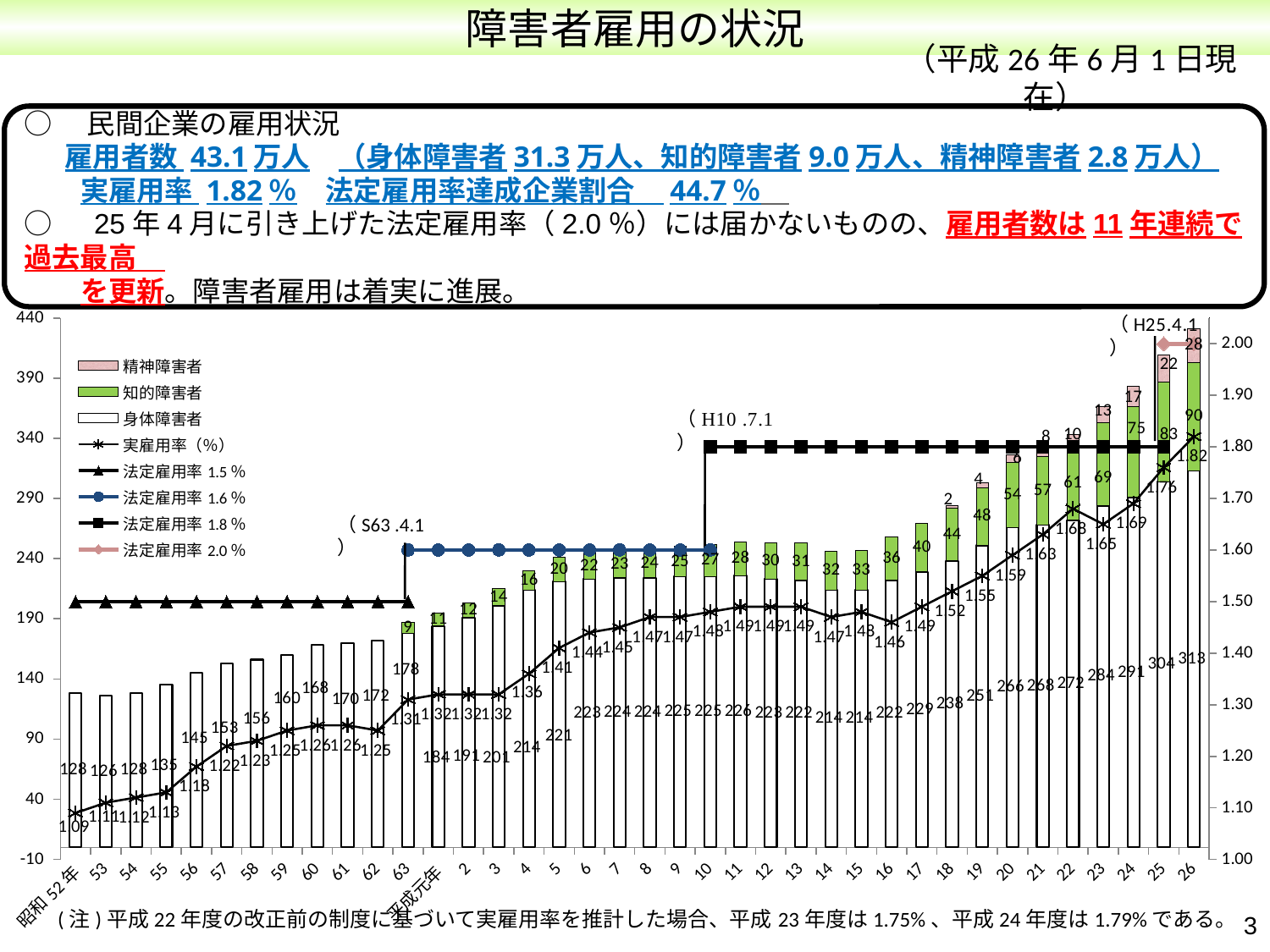
What is the value of 知的障害者 for 平成26年? 90 What is the 実雇用率（%） value for 昭和52年? 1.09 What is the difference between the 身体障害者 values for 平成26年 and 平成25年? 9 In which year is the 身体障害者 value highest? 平成26年 Does the 実雇用率（%） line generally rise or fall from 昭和52年 to 平成26年? Rise For 平成25年, which is larger: 知的障害者 or 精神障害者? 知的障害者 What is the 実雇用率（%） value for 平成26年? 1.82 What is the value of 身体障害者 for 平成26年? 313 What is the value of 精神障害者 for 平成26年? 28 What kind of chart is shown on the slide? Stacked bar chart with line series How many series does the chart legend list? 8 What is the total of the stacked bar for 平成26年 (身体障害者 + 知的障害者 + 精神障害者)? 431